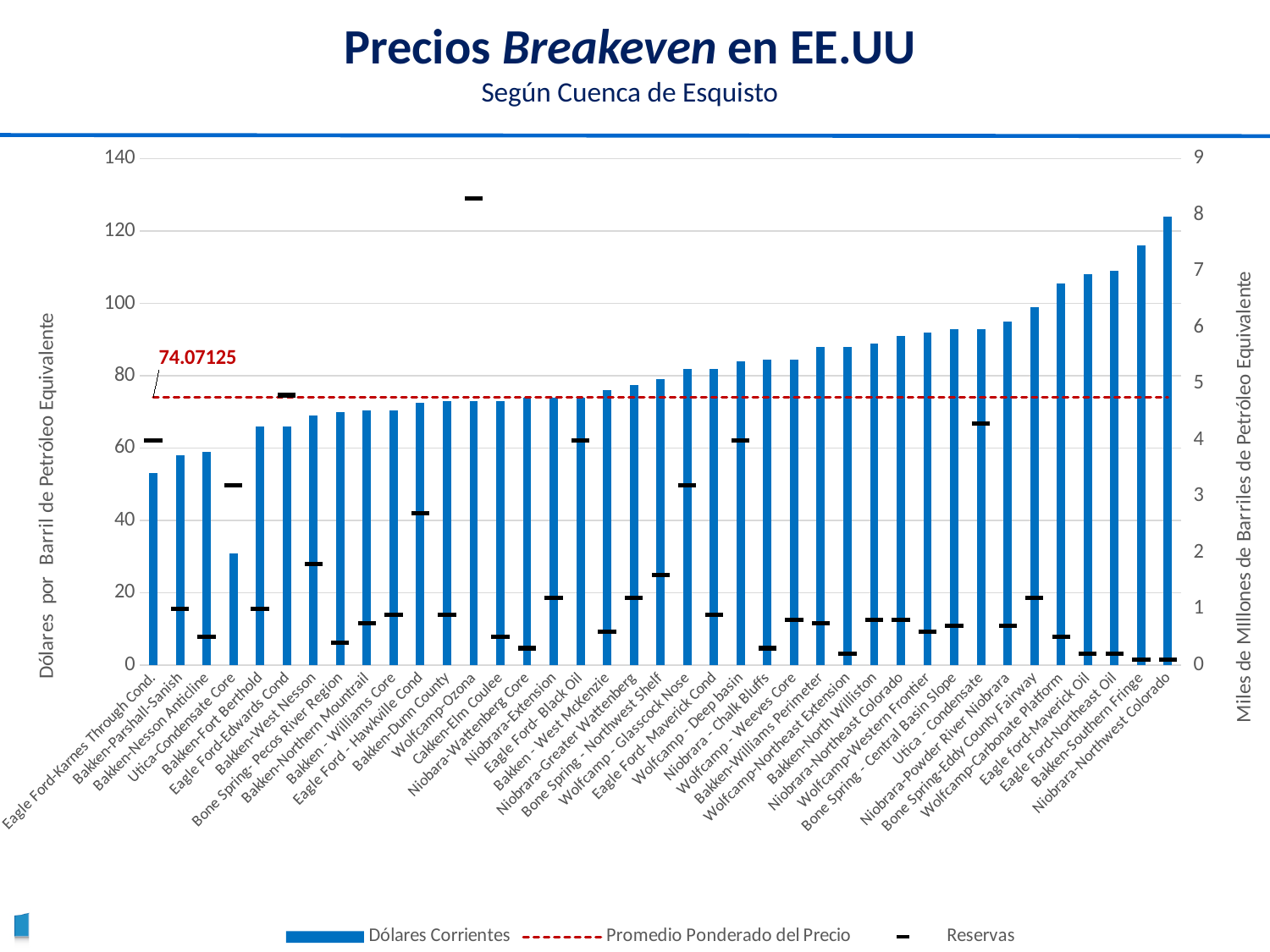
How many series does the legend list? 3 Which category has the highest bar for Dólares Corrientes? Niobrara-Northwest Colorado What is the label of the right-hand vertical axis? Miles de Millones de Barriles de Petróleo Equivalente Which has a higher Dólares Corrientes bar, Bakken-Parshall-Sanish or Eagle Ford-Northeast Oil? Eagle Ford-Northeast Oil Is the Dólares Corrientes value for Bakken-Southern Fringe greater or less than 100? greater What value is labelled on the red dashed line (Promedio Ponderado del Precio)? 74.07125 Is the Dólares Corrientes value for Eagle Ford-Karnes Through Cond. greater or less than 60? less Which category has the lowest bar for Dólares Corrientes? Utica-Condensate Core Is the Dólares Corrientes value for Utica-Condensate Core greater or less than 40? less Do the Dólares Corrientes bars generally rise or fall from left to right along the x axis? rise What kind of chart is shown on the slide? bar chart